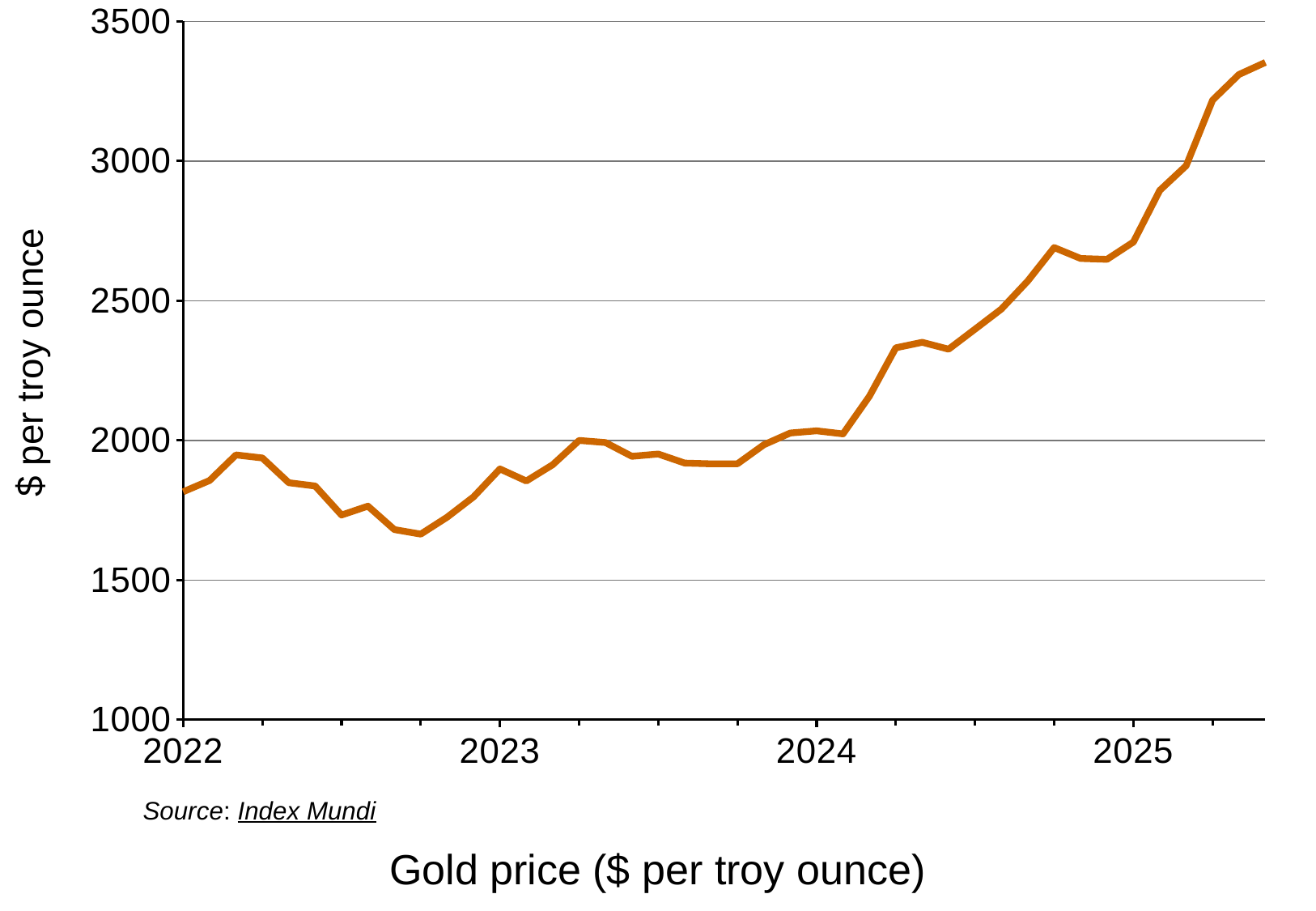
What is the label on the vertical axis of the chart? $ per troy ounce In which year does the line reach its highest point? 2025 What is the title of the chart? Gold price ($ per troy ounce) Is the gold price at the start of 2022 greater or less than 1500? greater Which is higher, the gold price at the start of 2022 or at the start of 2025? start of 2025 Is the gold price at the end of the plotted line (mid-2025) greater or less than 3000? greater Is the gold price at the start of 2025 greater or less than 2500? greater What kind of chart is shown on the slide? line chart Overall, does the gold price rise or fall from 2022 to 2025 along the x axis? rise